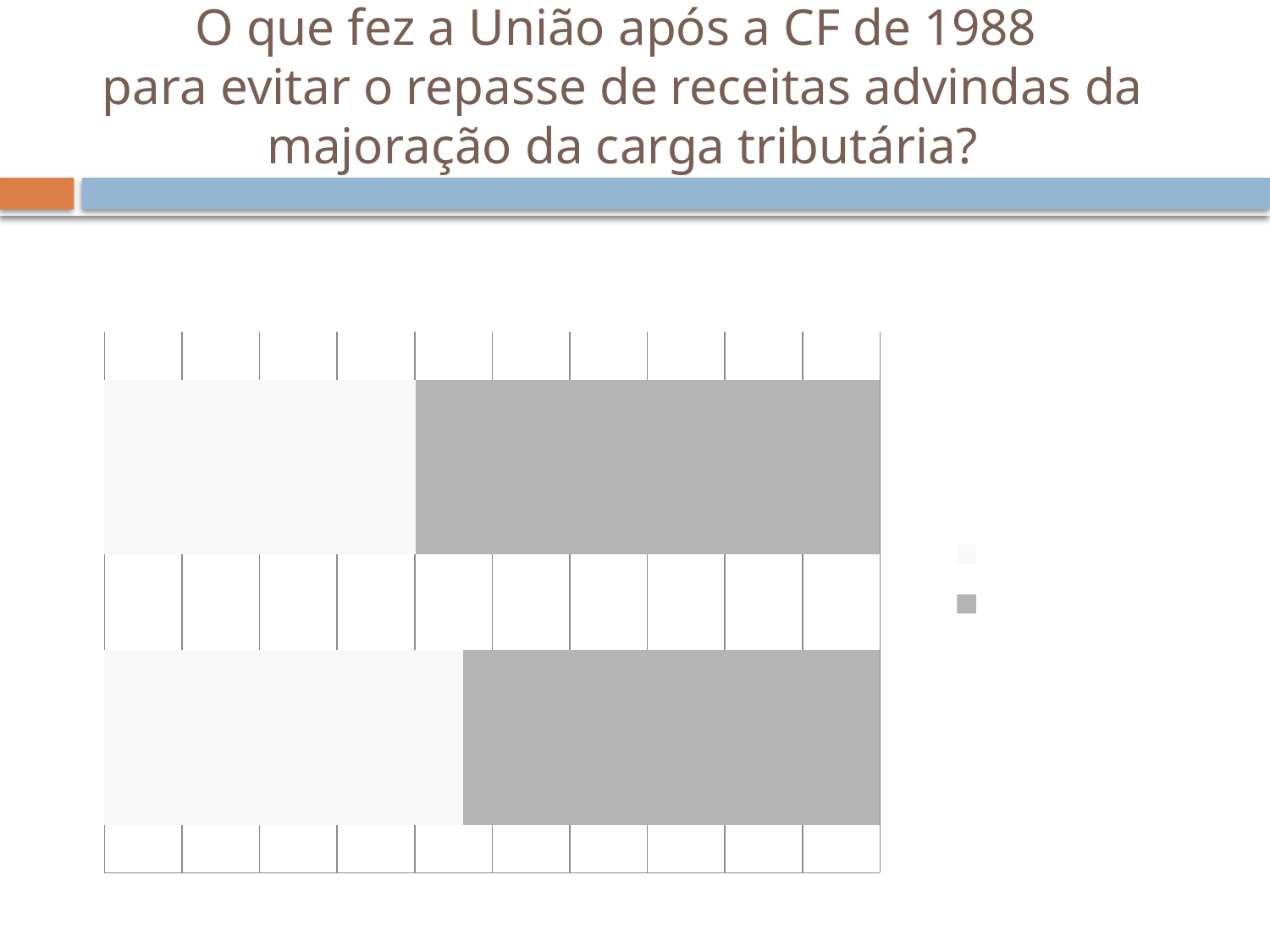
What kind of chart is shown on the slide? Bar chart In the top bar, which segment is longer, the light one or the dark grey one? The dark grey one How many bars does the chart contain? 2 Are the bars in the chart oriented horizontally or vertically? Horizontally How many entries does the chart's legend show? 2 Which bar has the longer light-coloured segment, the top bar or the bottom bar? The bottom bar How many segments does each stacked bar have? 2 Which bar has the longer dark grey segment, the top bar or the bottom bar? The top bar